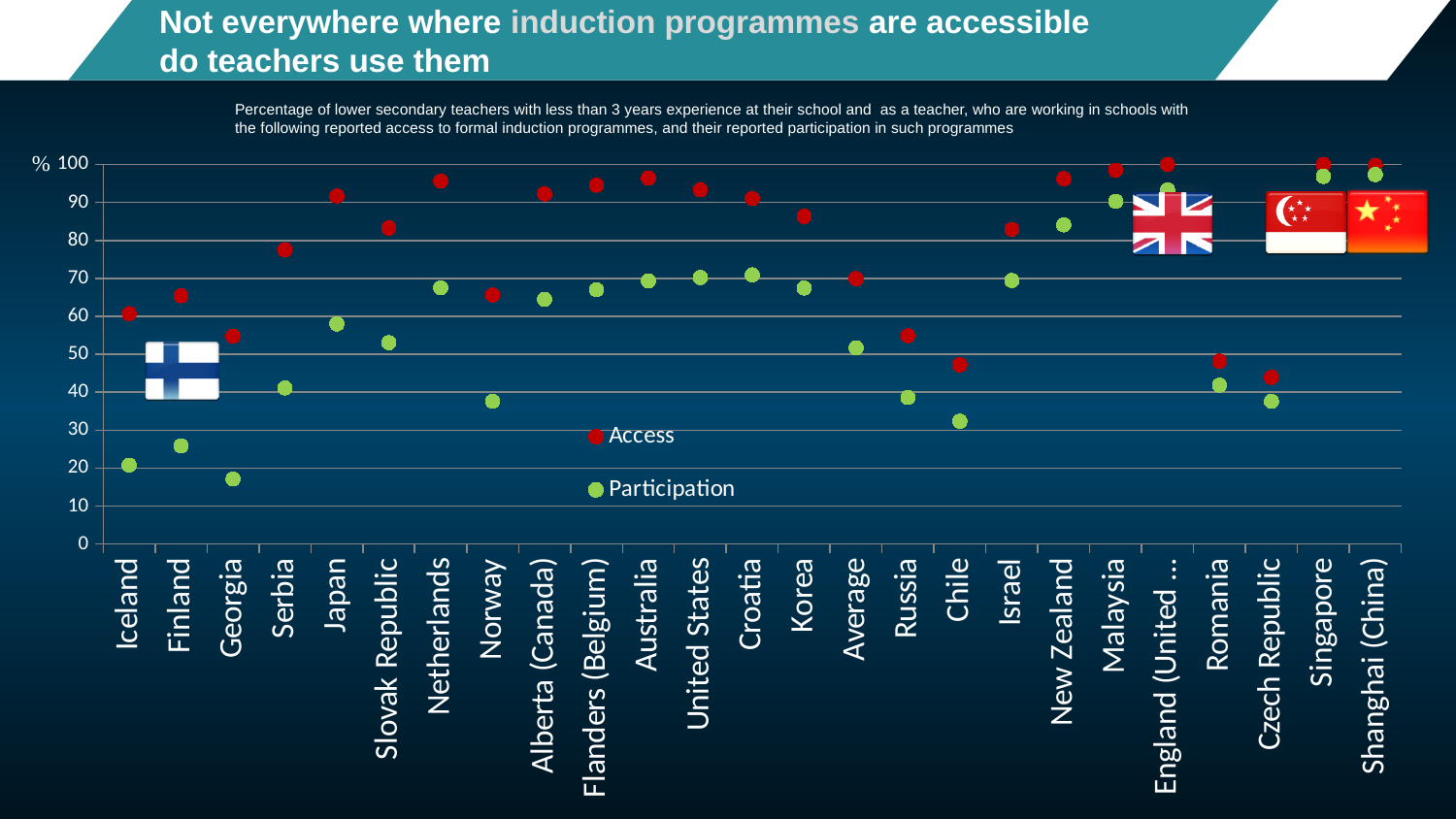
Is the Access value for Netherlands greater or less than 90? greater Which country has the lowest Participation value? Georgia How many countries or economies are shown along the x axis? 25 Is the Participation value for Georgia greater or less than 20? less How many series does the chart legend list? 2 For Chile, which is larger: the Access value or the Participation value? Access What are the two series named in the legend? Access and Participation What colour are the markers for the Access series? Red Is the Participation value for Norway greater or less than 40? less